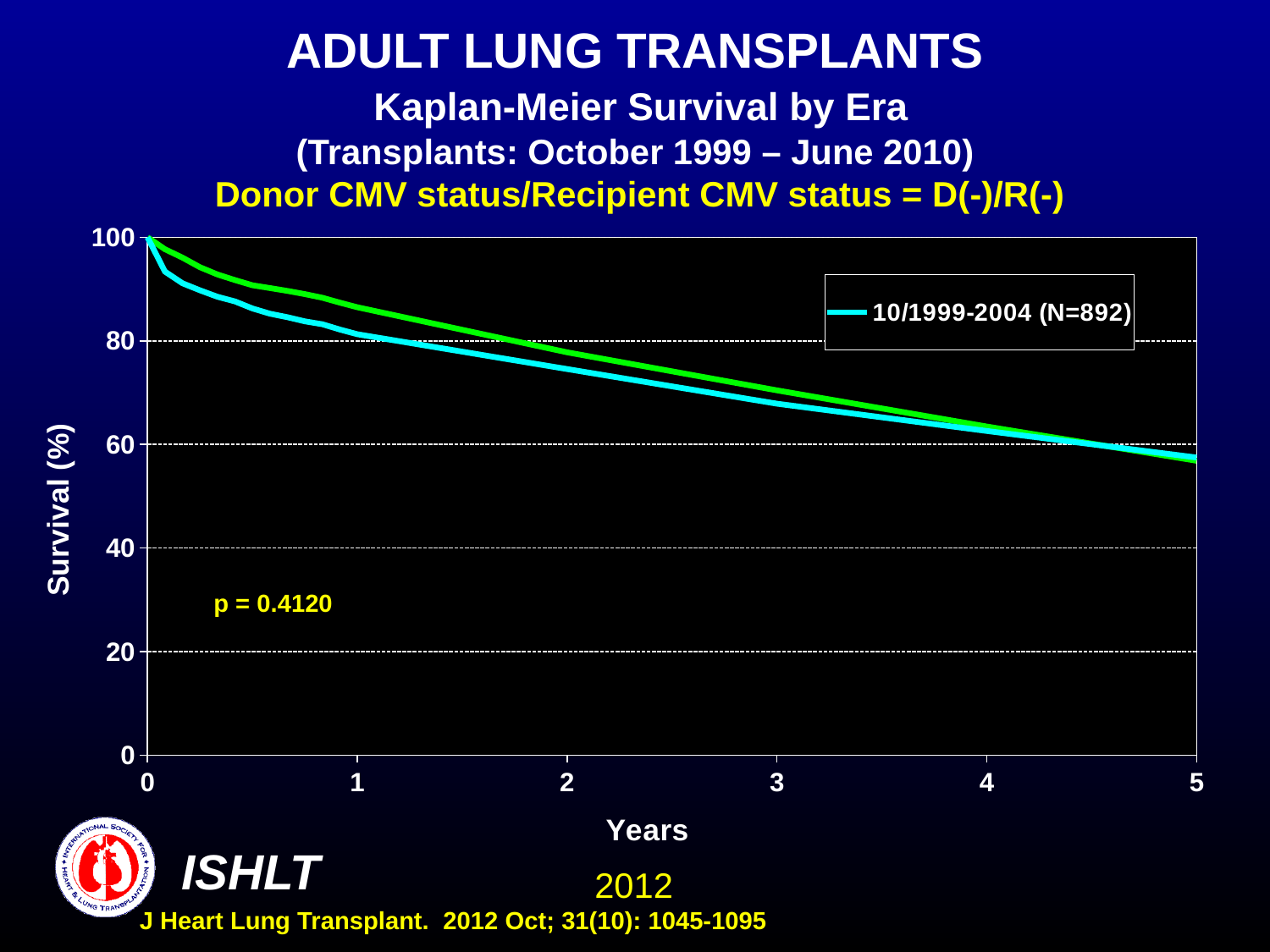
What is the label of the y axis? Survival (%) How many series does the legend list? 1 Is the survival value for the 10/1999-2004 (N=892) series at year 2 greater or less than 80? less Does survival rise or fall as years increase? fall Which series is listed in the legend? 10/1999-2004 (N=892) What kind of chart is shown on the slide? line chart What p-value is printed on the chart? p = 0.4120 Is the survival value for the 10/1999-2004 (N=892) series at year 3 greater or less than 60? greater Is the survival value for the 10/1999-2004 (N=892) series at year 5 greater or less than 60? less At year 1, which line is higher, the green line or the cyan 10/1999-2004 (N=892) line? the green line What is the maximum value shown on the x axis (Years)? 5 What is the survival value for the 10/1999-2004 (N=892) series at year 0? 100